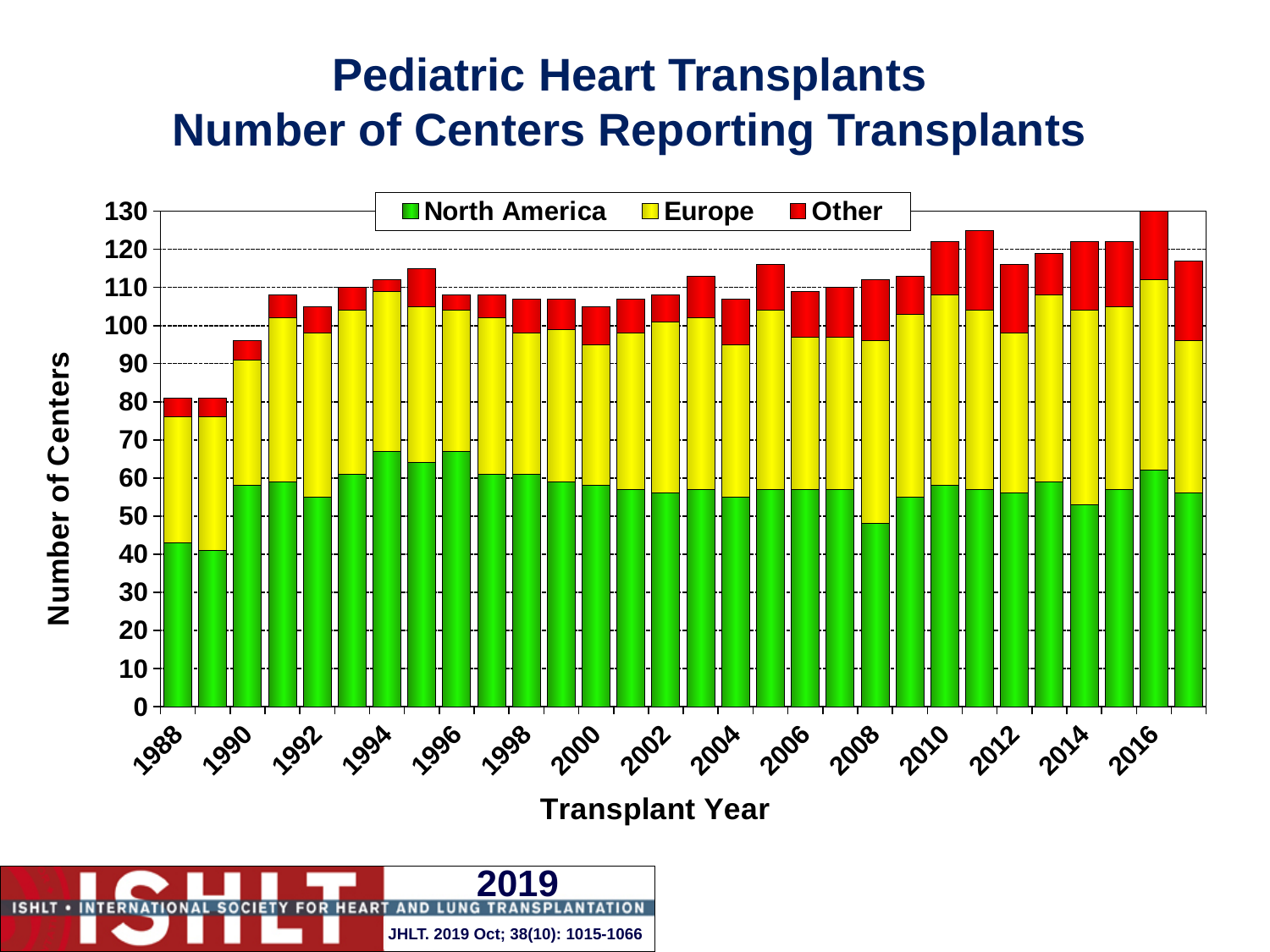
What kind of chart is shown on the slide? Stacked bar chart Which transplant year has the highest total number of centers? 2016 Does the total number of centers generally rise or fall from 1988 to 2017? rise Is the number of North America centers in 2008 greater or less than 60? less How many series does the legend list? 3 Which series are listed in the legend? North America, Europe, Other Which year has a larger total number of centers, 1988 or 2016? 2016 How many transplant years (bars) are plotted in the chart? 30 What colour represents North America in the chart? Green Is the total number of centers for 2016 greater or less than 120? greater Is the total number of centers for 2010 greater or less than 110? greater